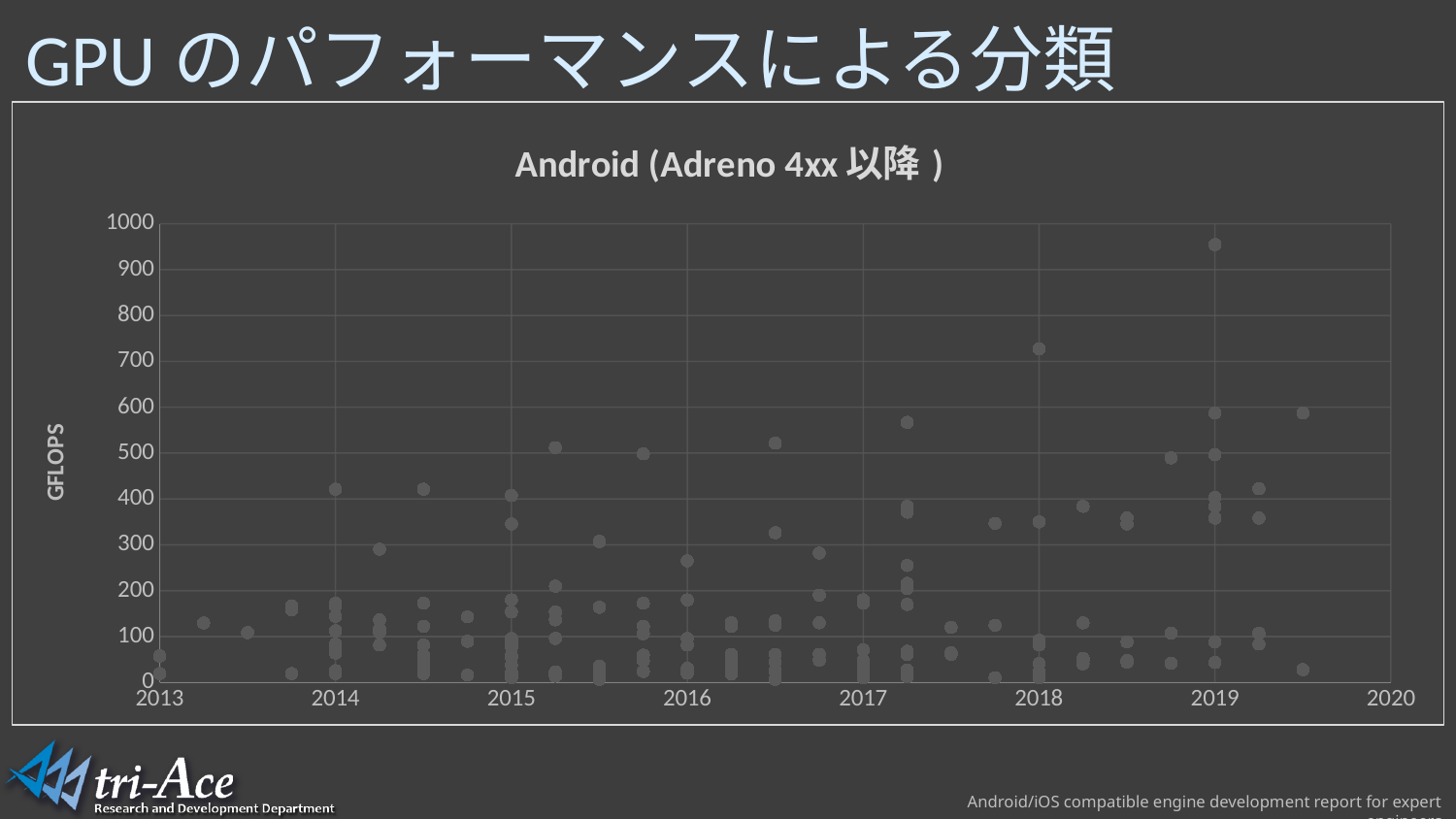
Do the maximum GFLOPS values generally rise or fall from 2013 to 2019? rise Is the highest point plotted in 2016 greater or less than 600? less Is the highest GFLOPS point on the chart greater or less than 900? greater Is the highest point plotted in 2015 greater or less than 400? greater What is the title of the chart? Android (Adreno 4xx 以降 ) In which year does the highest GFLOPS point on the chart appear? 2019 What kind of chart is shown on the slide? scatter chart What is the label on the vertical axis of the chart? GFLOPS